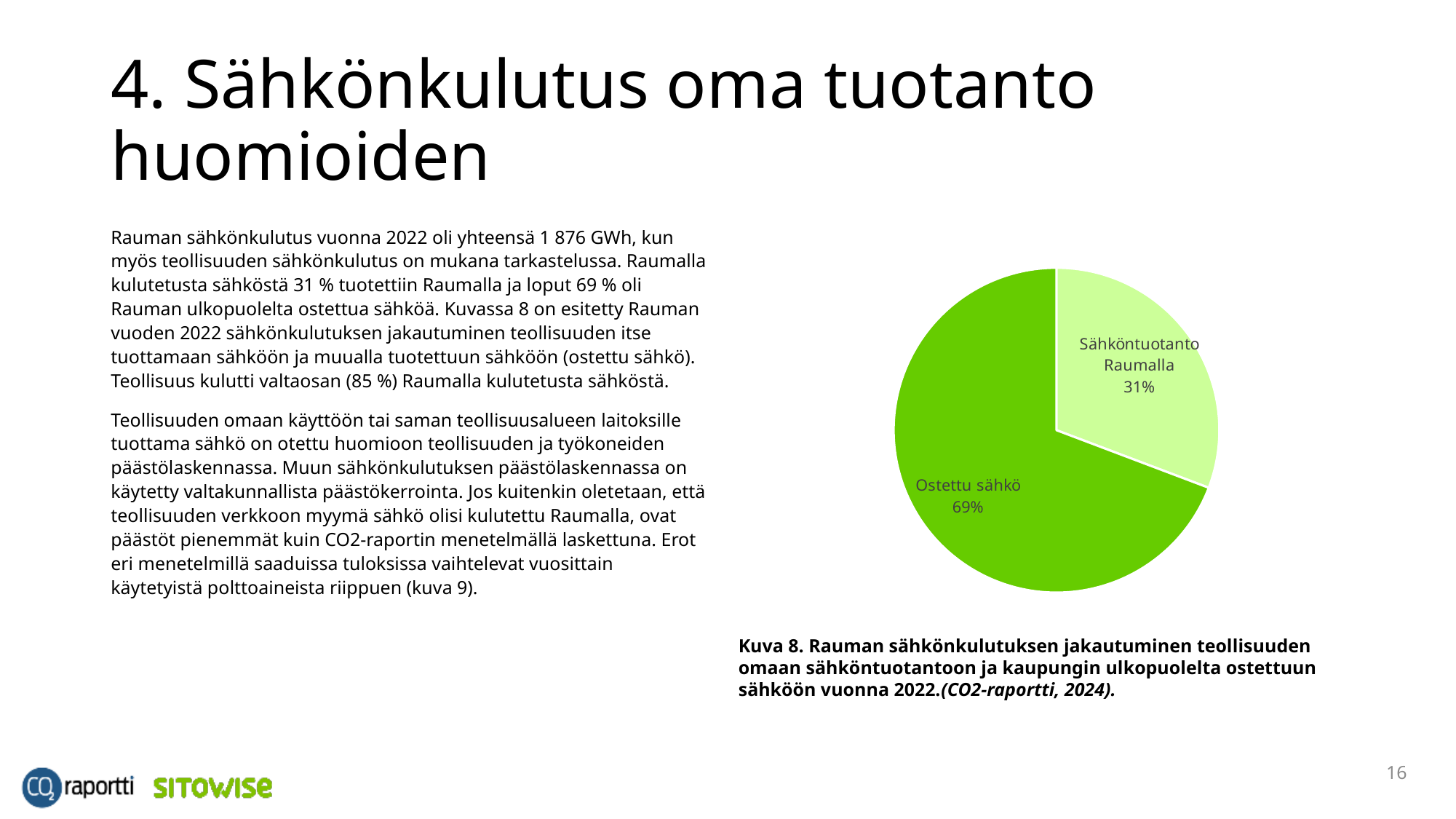
What is the difference in percentage points between the "Ostettu sähkö" slice and the "Sähköntuotanto Raumalla" slice? 38 How many slices does the pie chart have? 2 Is the share for "Sähköntuotanto Raumalla" greater or less than 50%? less What year does the pie chart's caption say the data is for? 2022 Which slice of the pie is the smallest? Sähköntuotanto Raumalla Which is larger, the share for "Ostettu sähkö" or the share for "Sähköntuotanto Raumalla"? Ostettu sähkö Which slice of the pie is the largest? Ostettu sähkö What share of the pie does "Ostettu sähkö" represent? 69% Which slice of the pie is drawn in the lighter green colour? Sähköntuotanto Raumalla What kind of chart is shown on the slide? pie chart What share of the pie does "Sähköntuotanto Raumalla" represent? 31%